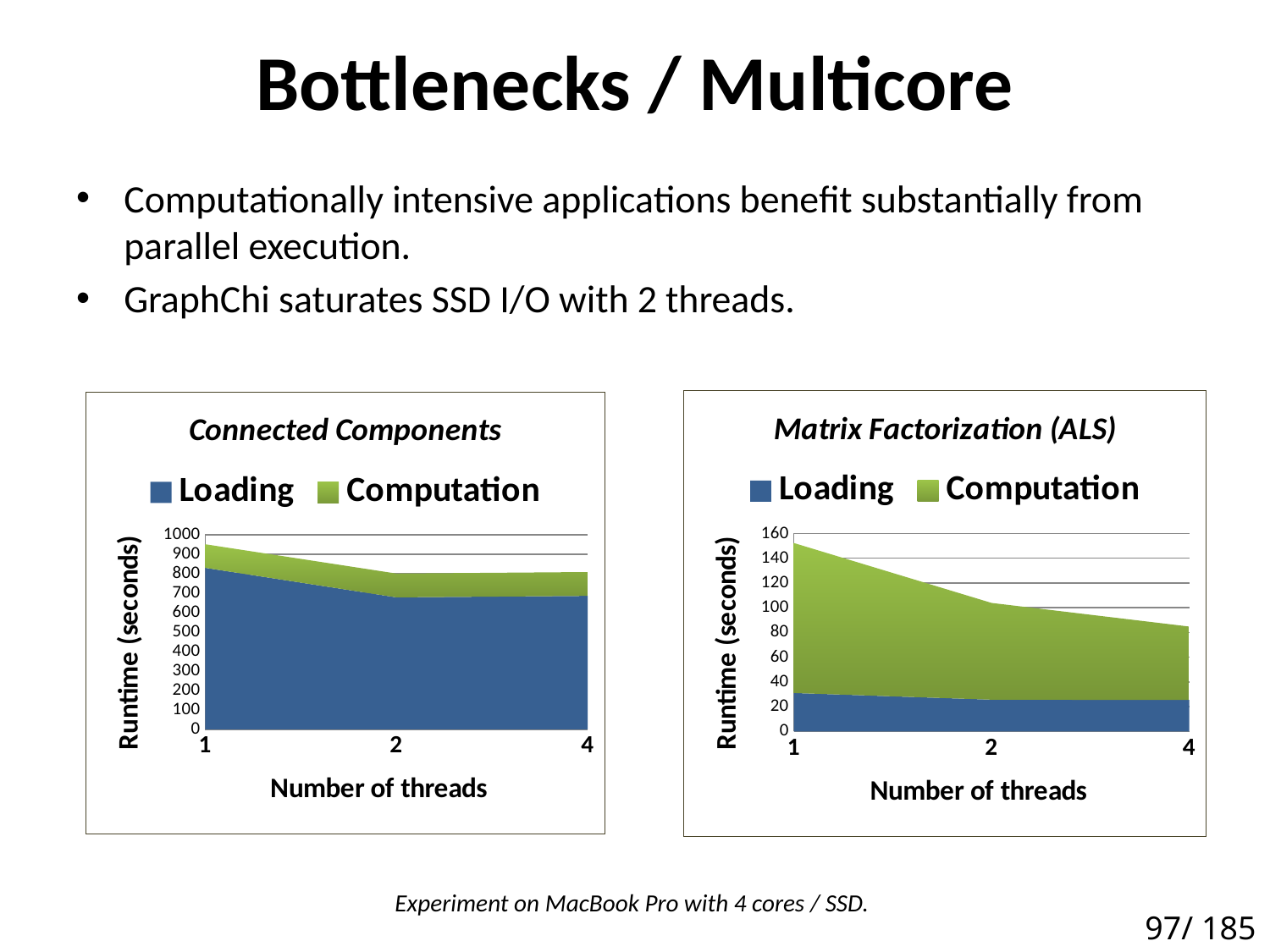
In the Matrix Factorization (ALS) chart, is the Loading value at 1 thread greater or less than 40? less In the Connected Components chart, is the total runtime at 1 thread greater or less than 900? greater In the Matrix Factorization (ALS) chart, at which number of threads is the total runtime lowest? 4 In the Connected Components chart, which is larger: the total runtime at 1 thread or at 2 threads? 1 thread In the Matrix Factorization (ALS) chart, does the total runtime rise or fall as the number of threads increases? fall What kind of chart is the Connected Components chart? area chart How many series does the legend of the Matrix Factorization (ALS) chart list? 2 How many thread counts are plotted along the x axis of the Connected Components chart? 3 What is the y-axis title of the Connected Components chart? Runtime (seconds) In the Matrix Factorization (ALS) chart, is the total runtime at 4 threads greater or less than 100? less In the Matrix Factorization (ALS) chart, at which number of threads is the total runtime highest? 1